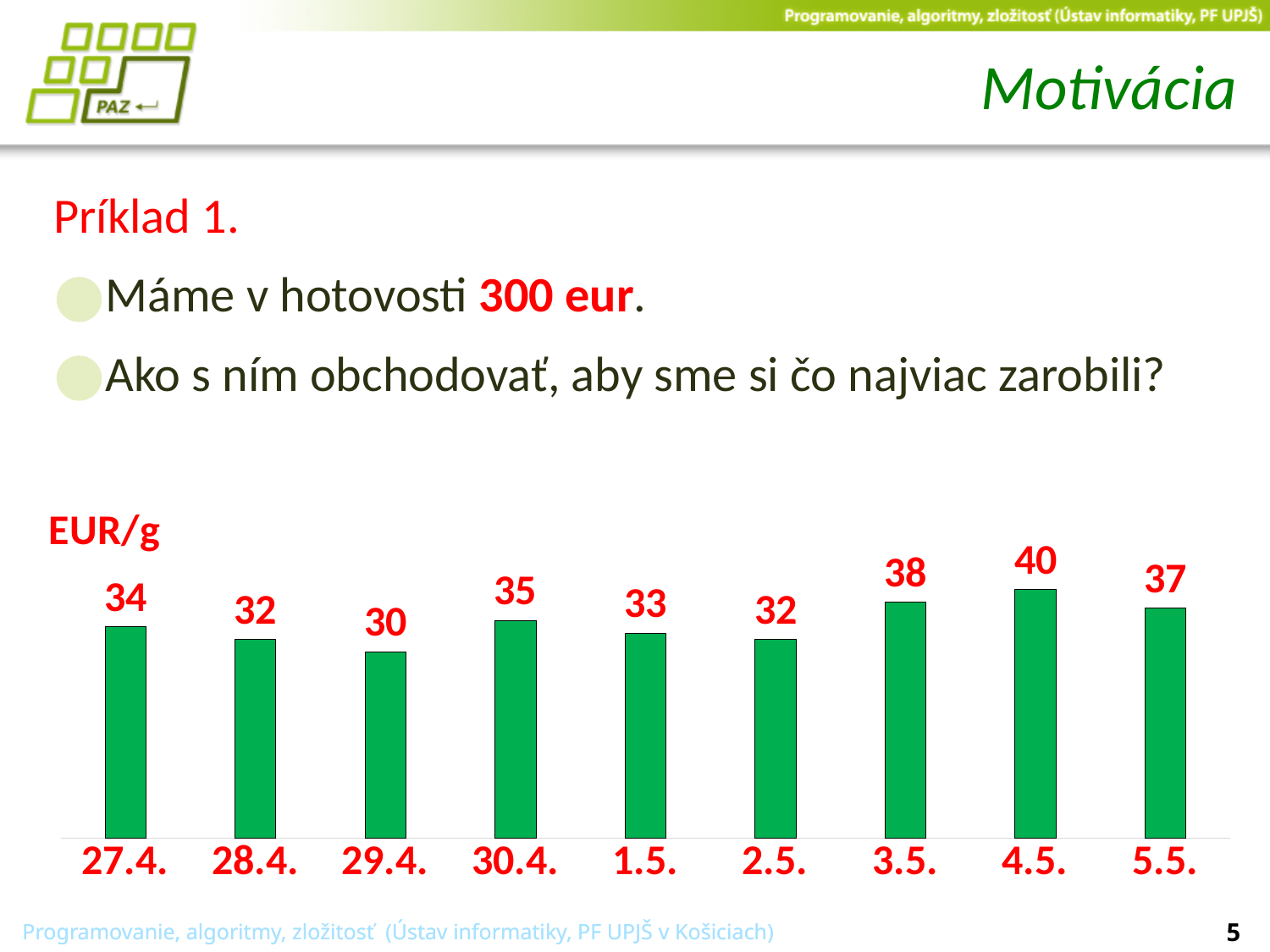
What is the value for 27.4.? 34 How many dates are shown on the x axis? 9 What kind of chart is this? bar chart What is the difference between the values for 5.5. and 4.5.? 3 Which date has the highest value? 4.5. What is the value for 3.5.? 38 What colour are the bars? green What is the difference between the values for 4.5. and 29.4.? 10 Which is larger, the value for 30.4. or the value for 1.5.? 30.4. What unit label is shown above the chart? EUR/g Which date has the lowest value? 29.4. Does the value rise or fall from 2.5. to 4.5.? rise